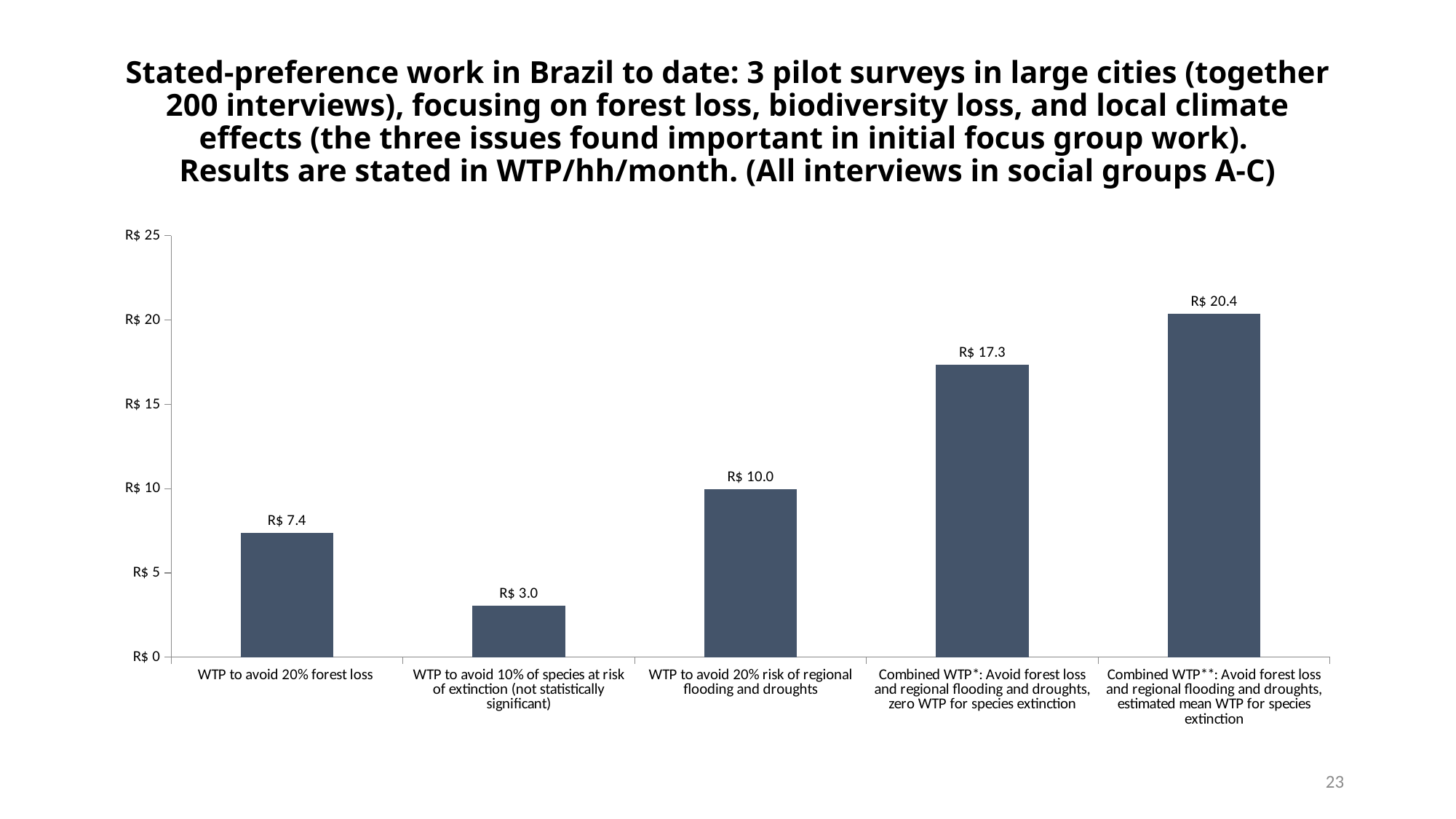
What is the difference between the Combined WTP** value and the Combined WTP* value? R$ 3.1 What is the WTP to avoid 20% forest loss? R$ 7.4 Which is larger: the WTP to avoid 20% forest loss or the WTP to avoid 20% risk of regional flooding and droughts? WTP to avoid 20% risk of regional flooding and droughts What is the WTP to avoid 20% risk of regional flooding and droughts? R$ 10.0 What kind of chart is shown on the slide? Bar chart What is the Combined WTP** value (estimated mean WTP for species extinction)? R$ 20.4 Which category has the lowest value? WTP to avoid 10% of species at risk of extinction (not statistically significant) What is the difference between the WTP to avoid 20% forest loss and the WTP to avoid 10% of species at risk of extinction? R$ 4.4 Which category has the highest value? Combined WTP**: Avoid forest loss and regional flooding and droughts, estimated mean WTP for species extinction Is the Combined WTP* value greater or less than R$ 15? greater How many categories are shown in the chart? 5 What is the WTP to avoid 10% of species at risk of extinction? R$ 3.0